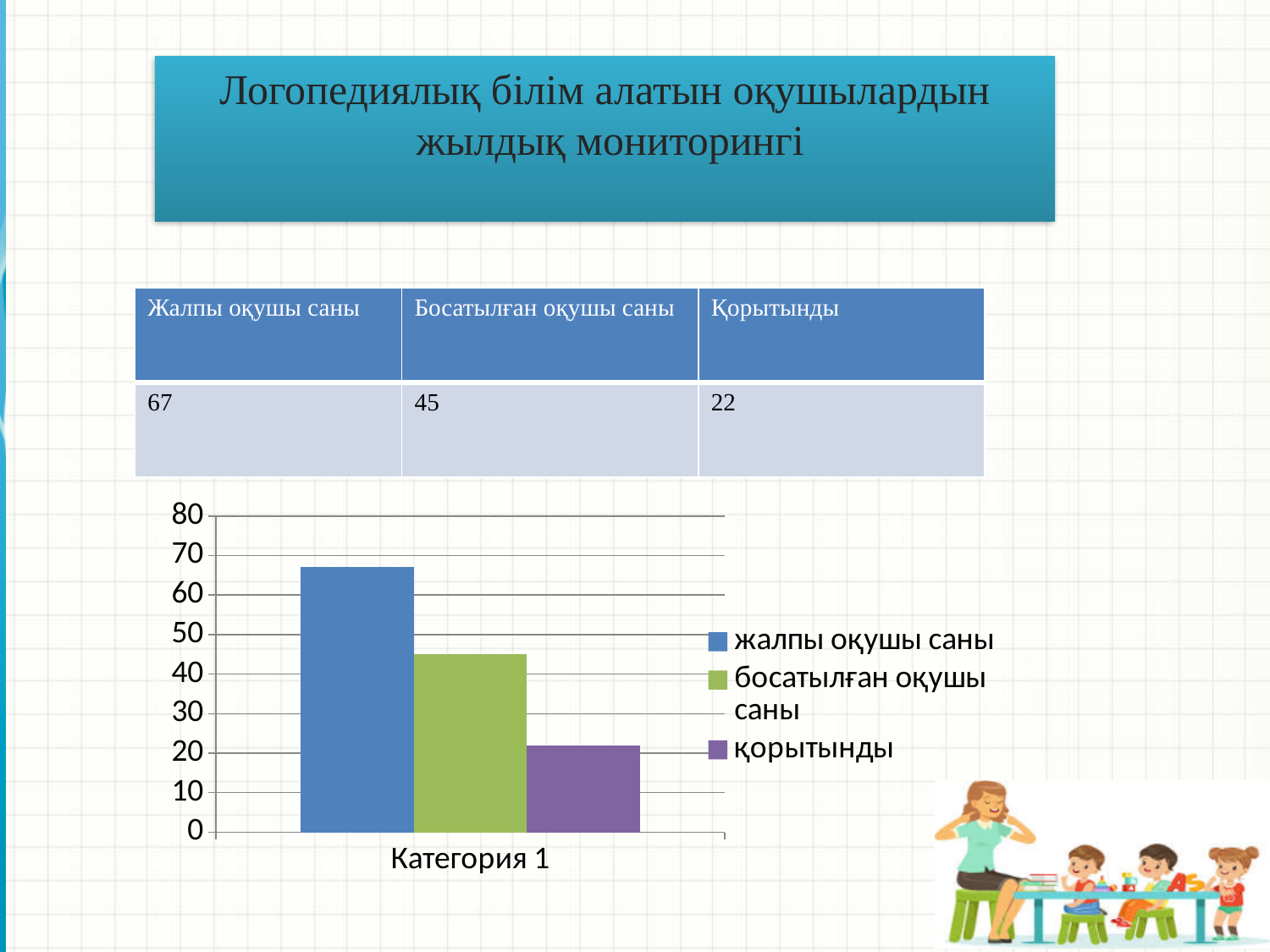
Which series has the lowest bar in the chart? қорытынды Is the value for босатылған оқушы саны greater or less than 50? less What kind of chart is shown on the slide? bar chart Is the value for қорытынды greater or less than 30? less According to the table on the slide, what is the value for Жалпы оқушы саны? 67 Which is larger, the bar for босатылған оқушы саны or the bar for қорытынды? босатылған оқушы саны What is the name of the category on the x axis of the chart? Категория 1 How many series does the chart legend list? 3 Which series has the highest bar in the chart? жалпы оқушы саны How many categories are shown on the x axis of the chart? 1 According to the table on the slide, what is the difference between Жалпы оқушы саны and Босатылған оқушы саны? 22 Is the value for жалпы оқушы саны greater or less than 60? greater